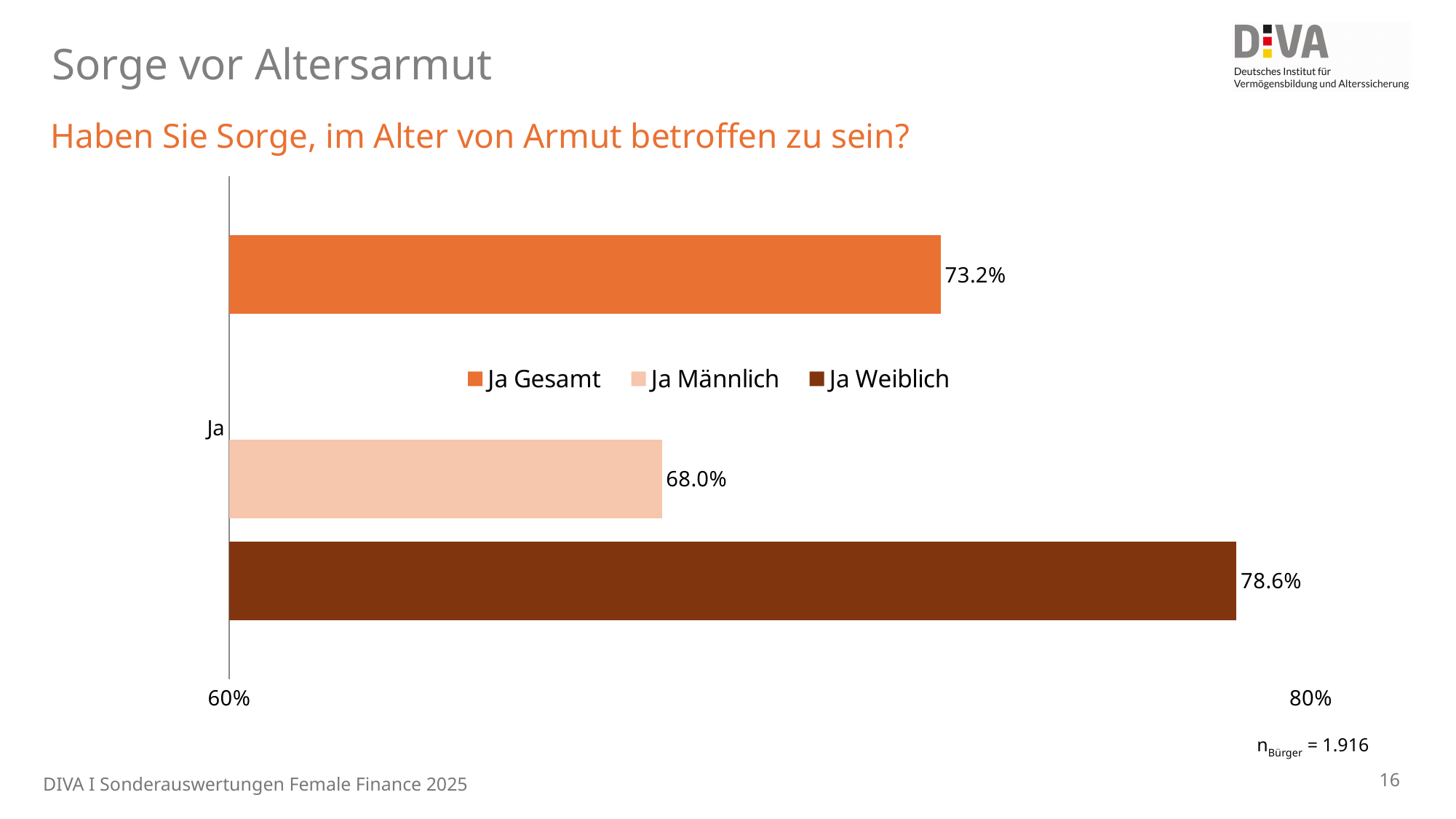
Which series has the lowest value? Ja Männlich What is the category label on the vertical axis of the chart? Ja What is the value for Ja Weiblich? 78.6% How many series does the legend list? 3 What is the value for Ja Männlich? 68.0% What kind of chart is shown on the slide? bar chart What is the difference between the values for Ja Gesamt and Ja Männlich? 5.2% Is the value for Ja Männlich greater or less than 80%? less Which is larger, the value for Ja Gesamt or the value for Ja Weiblich? Ja Weiblich What is the value for Ja Gesamt? 73.2% What is the difference between the values for Ja Weiblich and Ja Männlich? 10.6% Which series has the highest value? Ja Weiblich